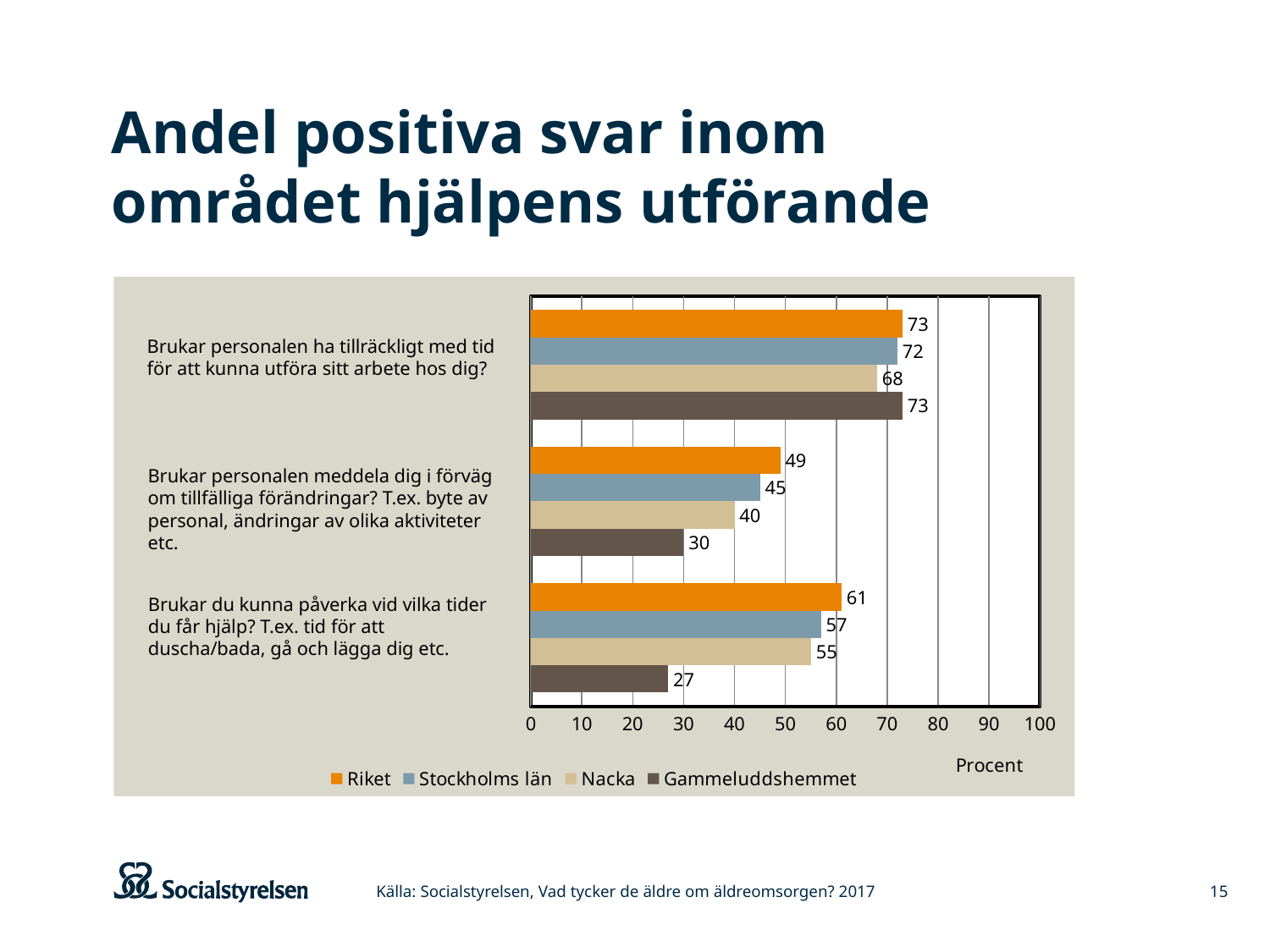
Which series has the lowest value for the question "Brukar personalen meddela dig i förväg om tillfälliga förändringar?"? Gammeluddshemmet What is the value for Gammeluddshemmet for the question "Brukar du kunna påverka vid vilka tider du får hjälp?"? 27 What is the value for Stockholms län for the question "Brukar personalen meddela dig i förväg om tillfälliga förändringar?"? 45 Which series has the highest value for the question "Brukar du kunna påverka vid vilka tider du får hjälp?"? Riket Which is larger for the question "Brukar personalen ha tillräckligt med tid för att kunna utföra sitt arbete hos dig?": Stockholms län or Nacka? Stockholms län How many question categories are shown on the chart? 3 What is the difference between Riket and Nacka for the question "Brukar personalen meddela dig i förväg om tillfälliga förändringar?"? 9 How many series does the legend list? 4 What is the value for Nacka for the question "Brukar personalen ha tillräckligt med tid för att kunna utföra sitt arbete hos dig?"? 68 What is the difference between Riket and Gammeluddshemmet for the question "Brukar du kunna påverka vid vilka tider du får hjälp?"? 34 What unit label is shown below the x axis of the chart? Procent What kind of chart is shown on the slide? Bar chart